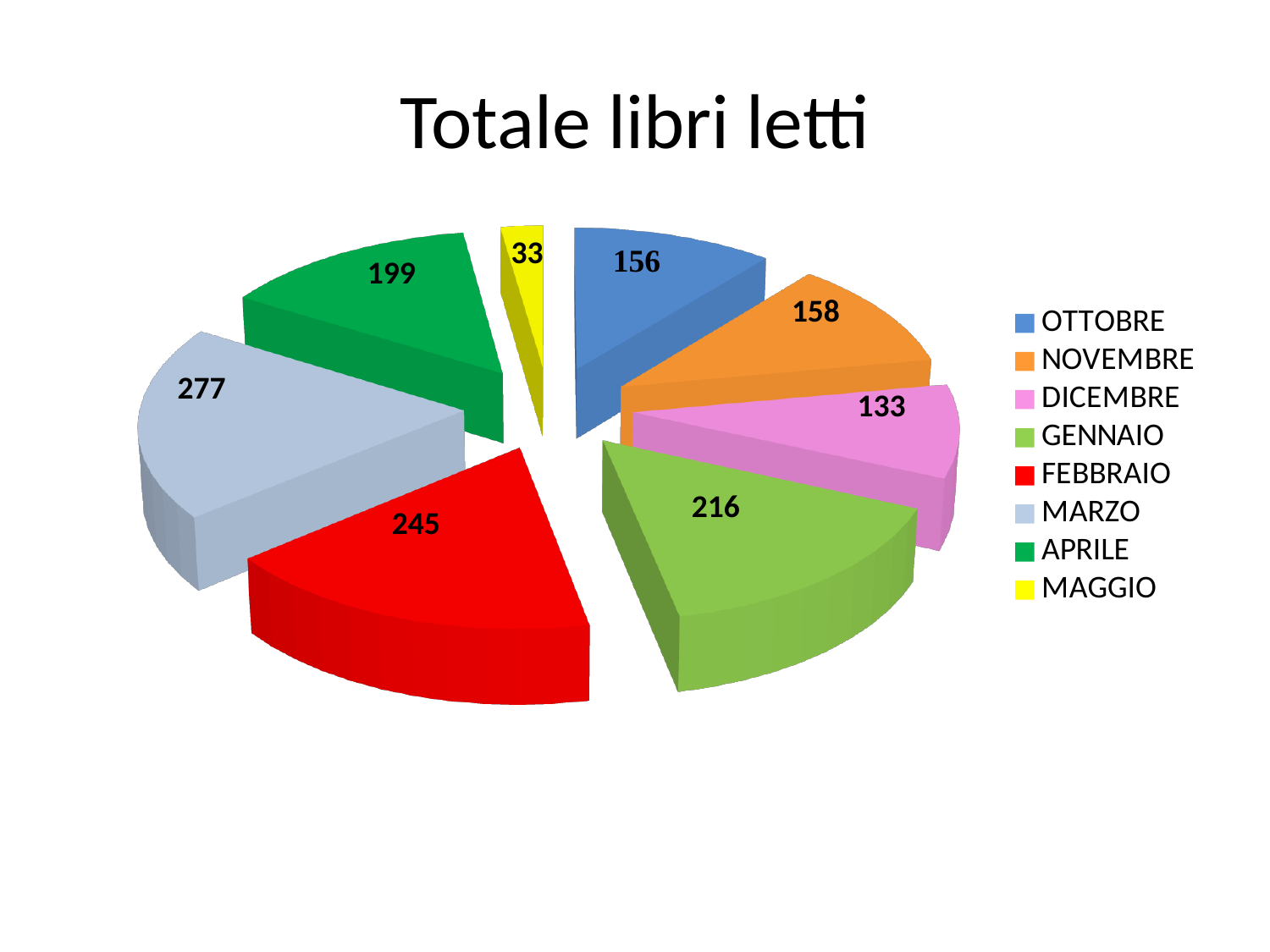
What is the value for MAGGIO? 33 What is the value for MARZO? 277 Which is larger, the value for NOVEMBRE or the value for OTTOBRE? NOVEMBRE What is the title of the chart? Totale libri letti Which colour represents FEBBRAIO in the legend? red What is the value for GENNAIO? 216 What is the difference between the values for MARZO and DICEMBRE? 144 How many slices does the pie chart have? 8 Which month has the lowest value? MAGGIO What type of chart is shown on the slide? pie chart Which month has the highest value? MARZO What is the difference between the values for FEBBRAIO and APRILE? 46